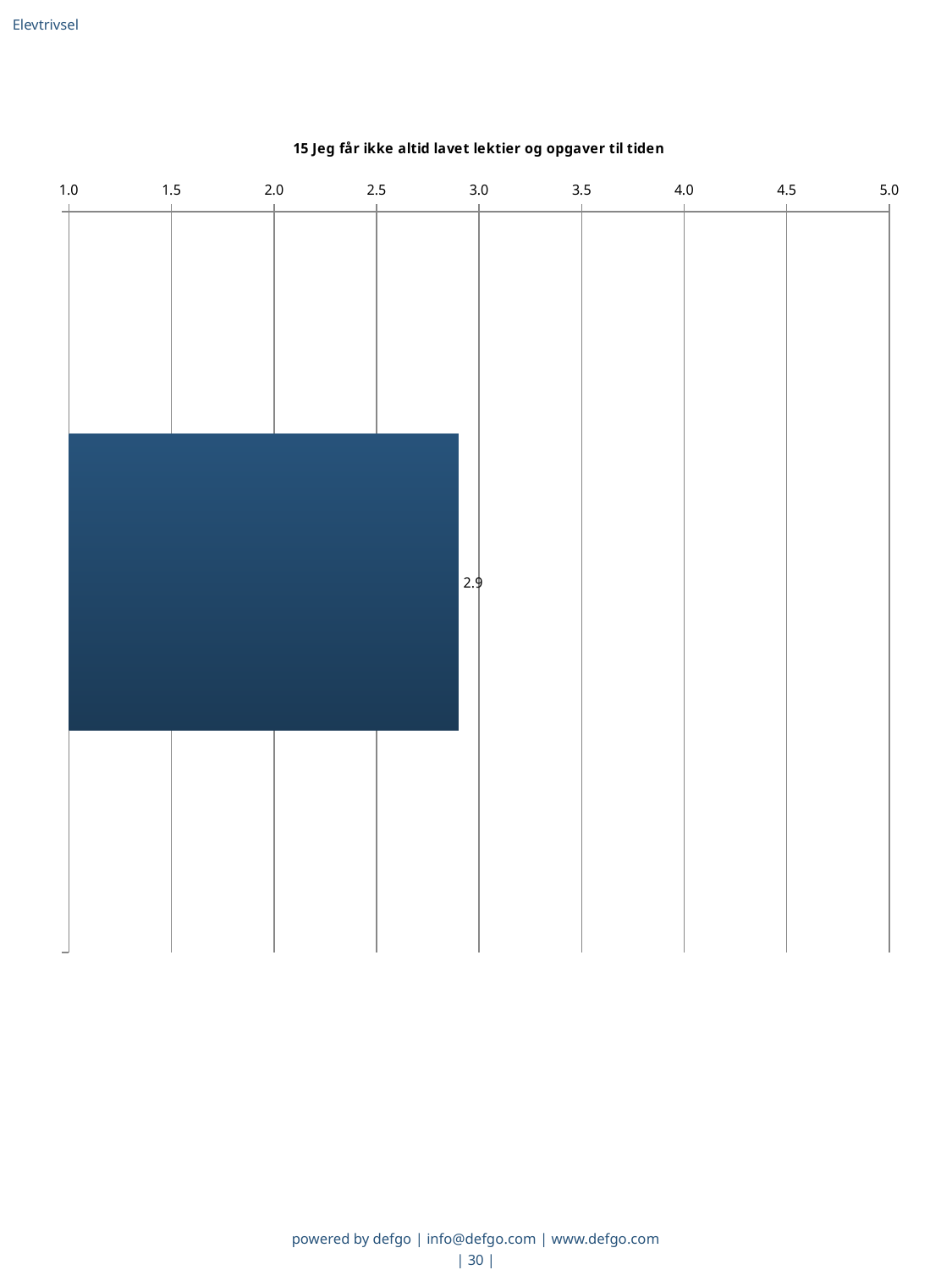
How many bars are plotted in the chart? 1 Is the value of the bar greater or less than 2.5? greater What is the highest value shown on the chart's axis? 5.0 What is the title of the chart? 15 Jeg får ikke altid lavet lektier og opgaver til tiden Is the bar in the chart horizontal or vertical? horizontal What kind of chart is shown on the slide? bar chart What is the value shown by the bar in the chart? 2.9 Is the value of the bar greater or less than 3.0? less